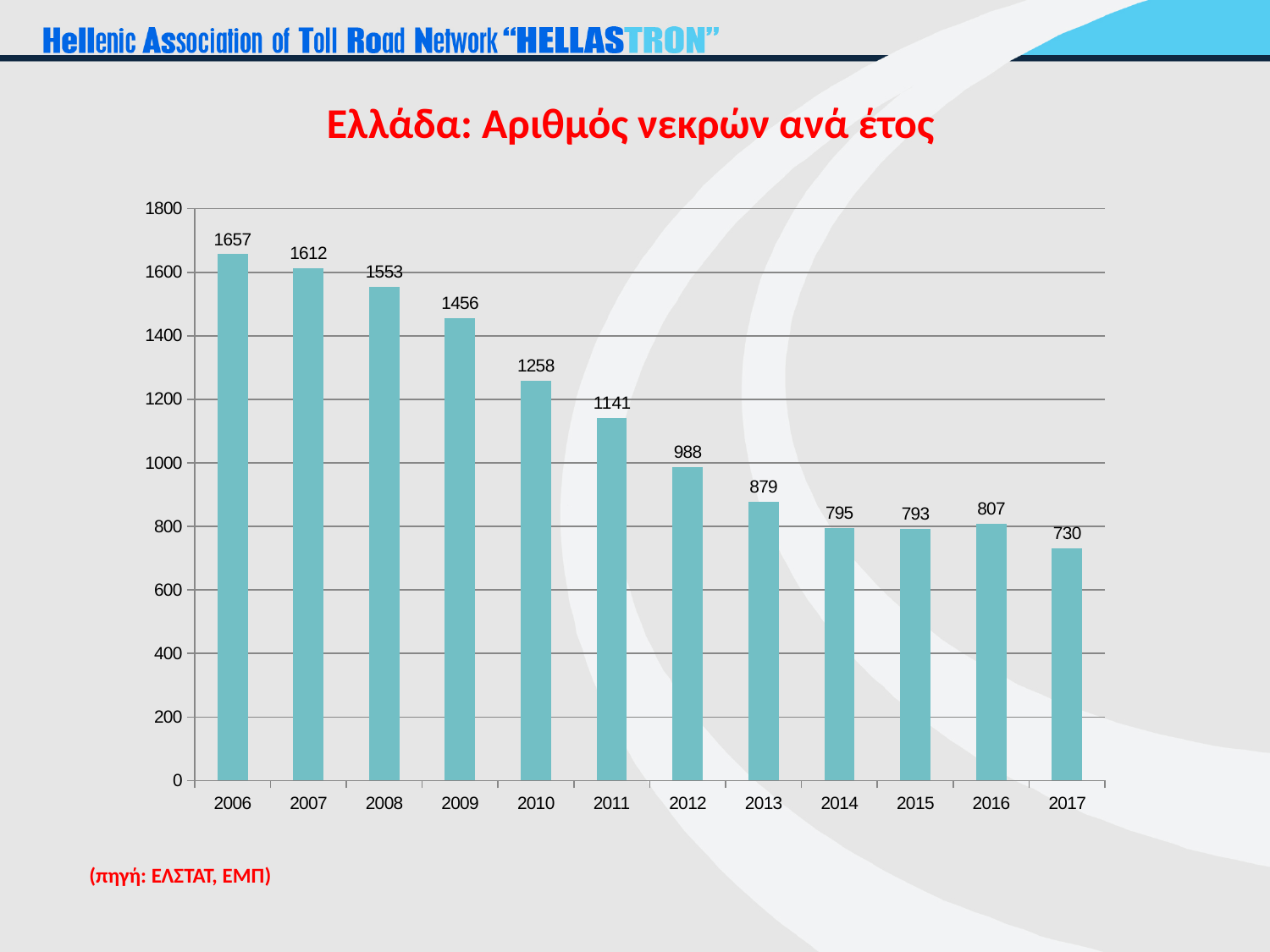
Which year has the lowest value? 2017 Do the values generally rise or fall from 2006 to 2017? fall What is the value for 2012? 988 What is the value for 2017? 730 Is the value for 2009 greater or less than 1400? greater What is the difference between the values for 2006 and 2017? 927 What is the value for 2006? 1657 How many years are shown on the x axis? 12 What is the difference between the values for 2010 and 2011? 117 Which is larger, the value for 2013 or the value for 2016? 2013 Which year has the highest value? 2006 What kind of chart is this? bar chart